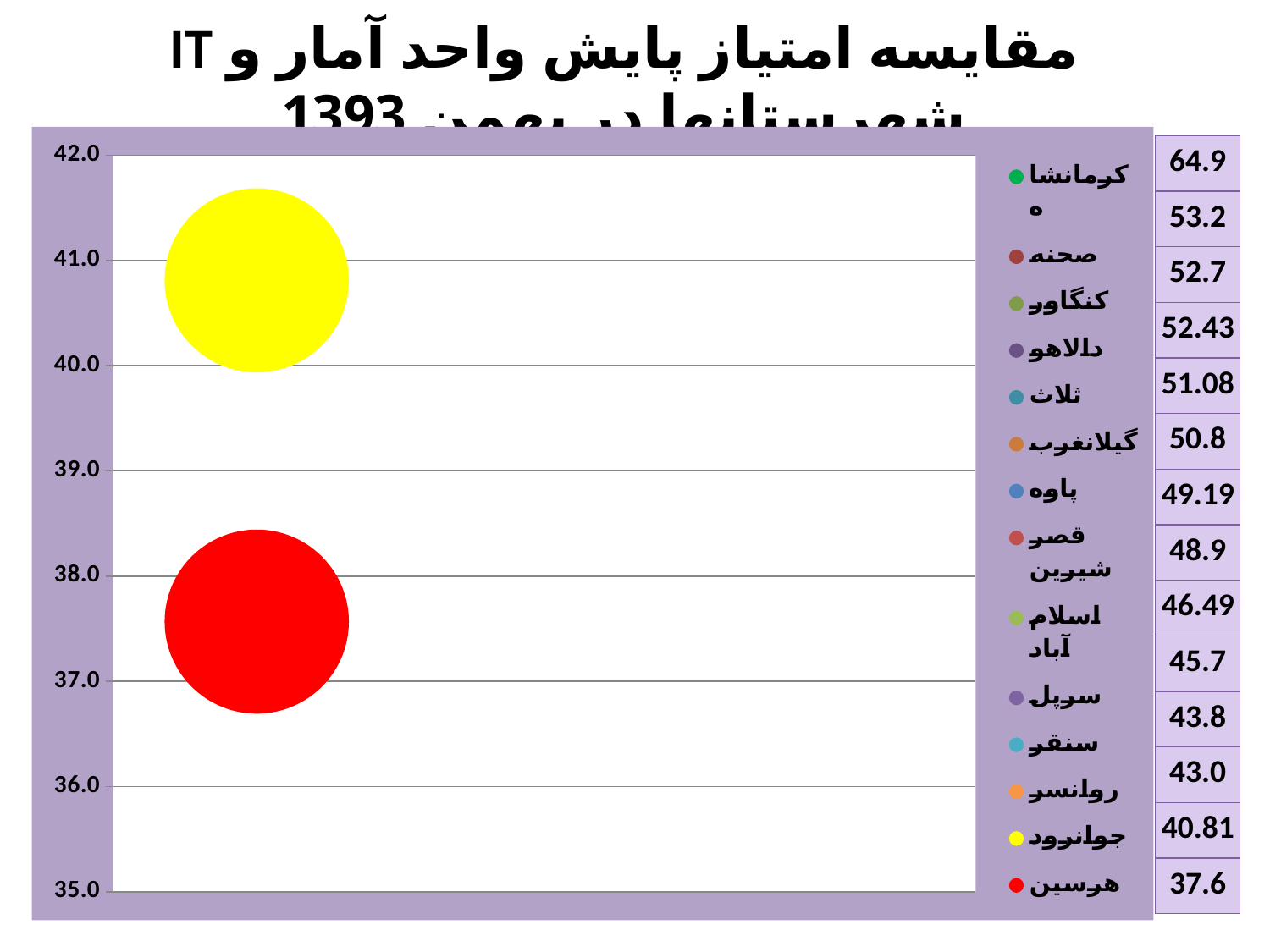
Which entry has the lowest value in the table beside the chart? هرسین Is the red bubble (هرسین) plotted greater or less than 39.0 on the y axis? less What is the difference between the values for جوانرود and هرسین? 3.21 According to the table beside the chart, what is the value for جوانرود? 40.81 Which bubble is plotted higher on the y axis, the yellow one (جوانرود) or the red one (هرسین)? the yellow one (جوانرود) How many bubbles are plotted in the chart area? 2 Is the yellow bubble (جوانرود) plotted greater or less than 40.0 on the y axis? greater According to the table beside the chart, what is the value for کرمانشاه? 64.9 What kind of chart is shown on the slide? bubble chart How many entries does the legend list? 14 Which entry has the highest value in the table beside the chart? کرمانشاه According to the table beside the chart, what is the value for هرسین? 37.6